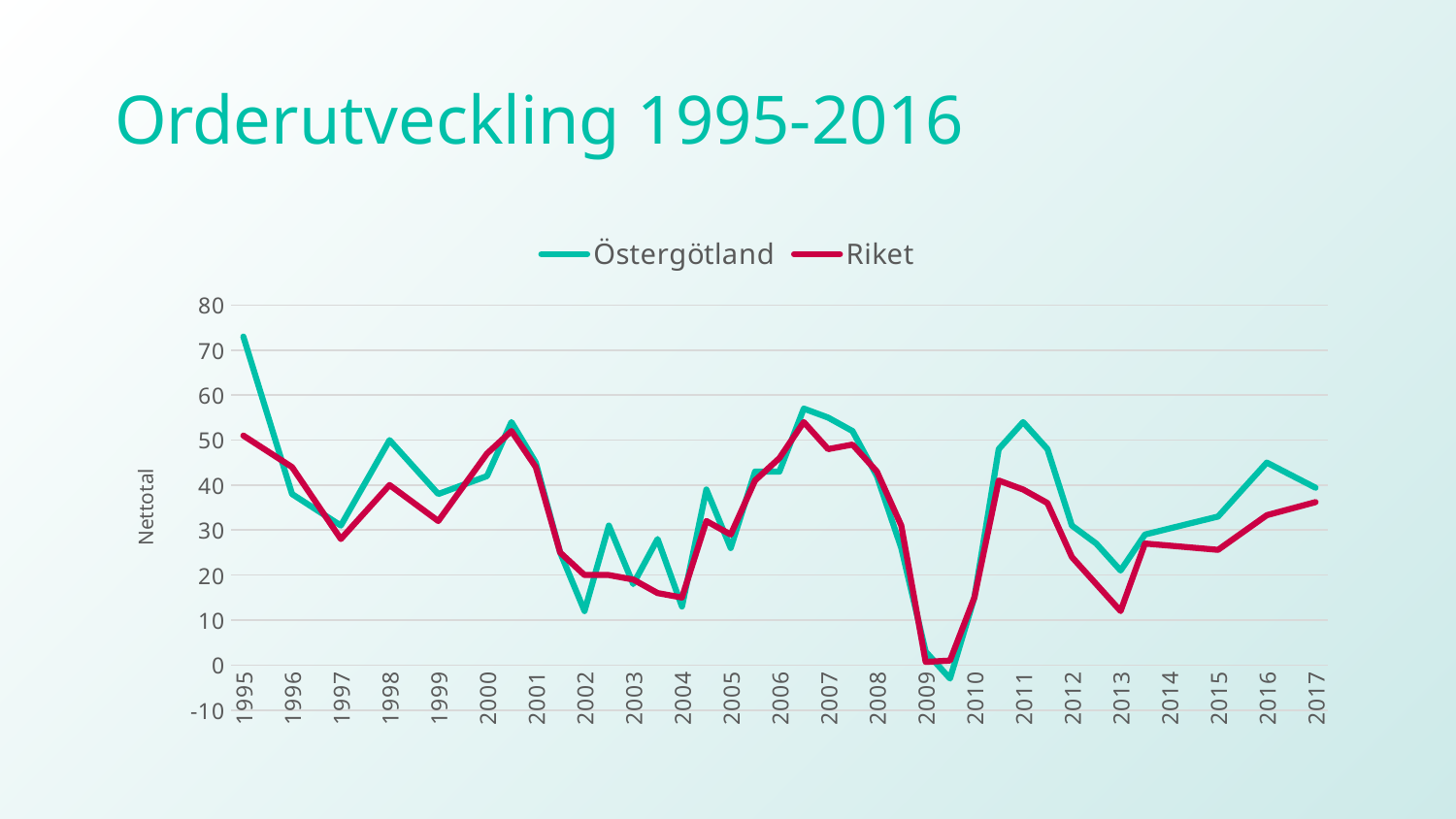
Does the Östergötland series rise or fall between 2013 and 2016? Rise What are the two series named in the legend? Östergötland and Riket Is the value for Riket in 2013 greater or less than 20? less How many series does the legend list? 2 What kind of chart is shown on the slide? Line chart In 2013, which series has the larger value, Östergötland or Riket? Östergötland Is the value for Östergötland in 2016 greater or less than 40? greater In which year does the Östergötland series reach its highest value? 1995 In which year does the Östergötland series reach its lowest value? 2009 What is the title of the chart? Orderutveckling 1995-2016 Is the value for Östergötland in 1995 greater or less than 70? greater How many year labels are shown on the x axis? 23